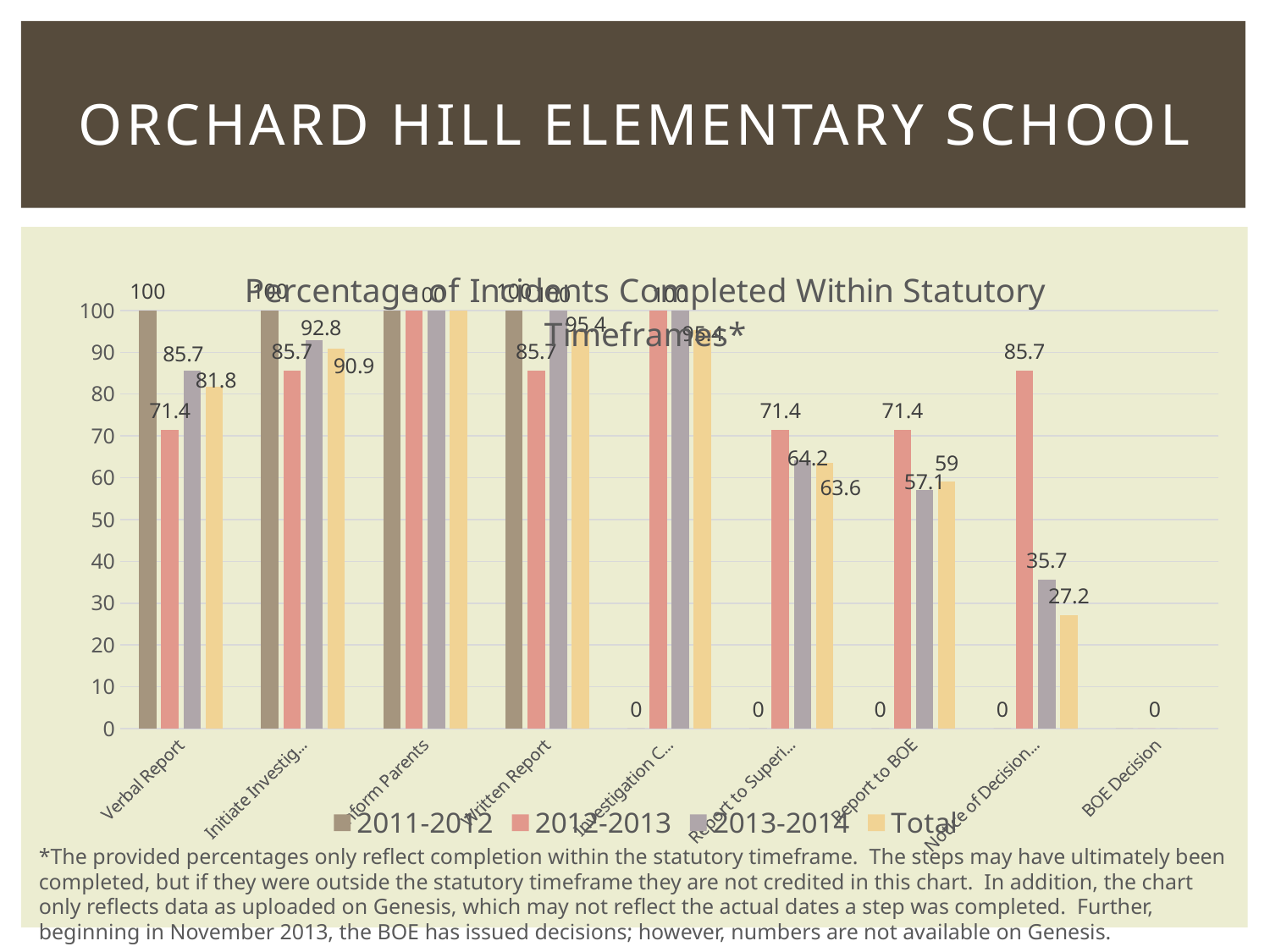
How many series does the legend list? 4 What is the value for 2012-2013 in the Verbal Report category? 71.4 What is the difference between the 2012-2013 and 2013-2014 values for Report to BOE? 14.3 What is the value for 2012-2013 in the Written Report category? 85.7 What is the Total value for the Report to BOE category? 59 Which is larger for Verbal Report: the 2013-2014 value or the Total value? 2013-2014 What is the Total value for the Verbal Report category? 81.8 What is the value for 2013-2014 in the Report to BOE category? 57.1 Which series has the lowest value in the Verbal Report category? 2012-2013 What is the value for 2011-2012 in the Inform Parents category? 100 How many categories are shown on the x axis? 9 What kind of chart is shown on the slide? Bar chart